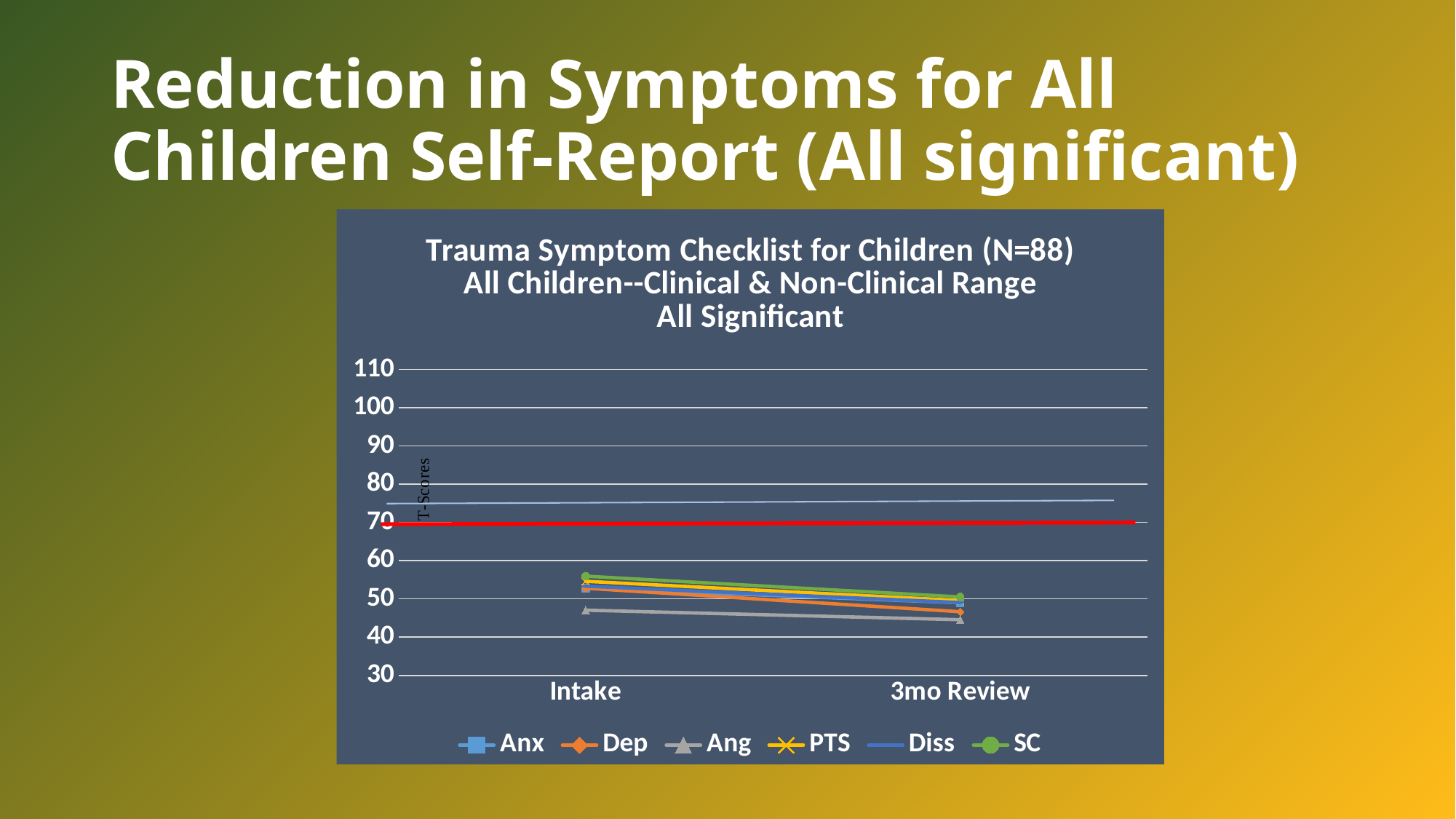
How many time points are shown on the x axis? 2 What kind of chart is shown on the slide? line chart Is the value for Dep at 3mo Review greater or less than 50? less What are the two categories on the x axis? Intake and 3mo Review Which series has the lowest value at Intake? Ang Is the value for Ang at Intake greater or less than 50? less What is the label on the y axis of the chart? T-Scores Is the value for Anx at Intake greater or less than 50? greater At Intake, which is larger: the value for SC or the value for Ang? SC Do the symptom scores rise or fall from Intake to 3mo Review? fall How many series does the legend list? 6